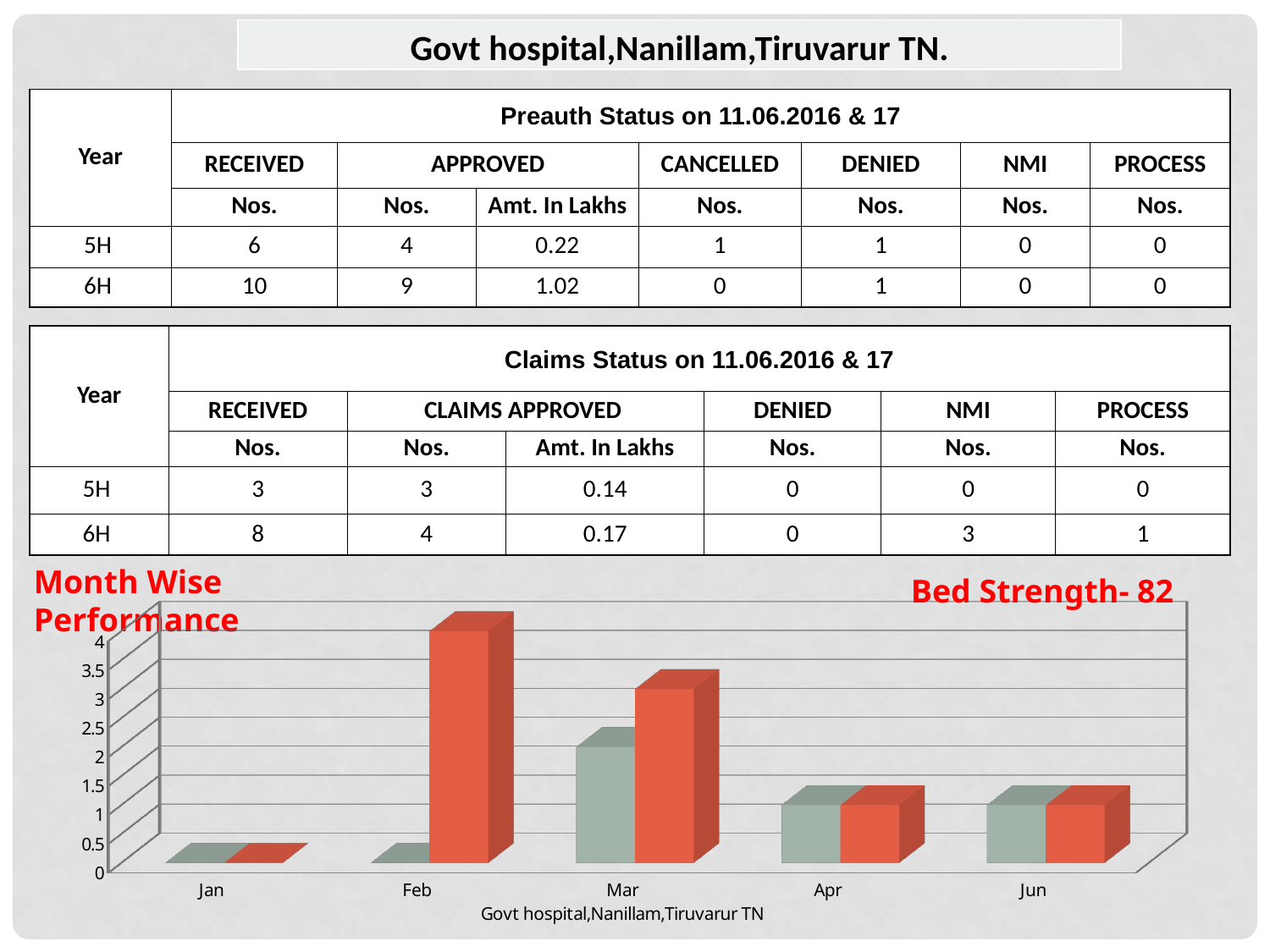
Which month has the lowest bars in the bar chart? Jan Which is taller, the red bar for Feb or the red bar for Mar? Feb Is the grey bar for Mar greater or less than 1.5? greater In Mar, which bar is taller, the grey bar or the red bar? red Do the red bars rise or fall from Feb to Apr? fall Is the red bar for Feb greater or less than 3? greater How many months are shown on the x axis of the bar chart? 5 What label is printed below the x axis of the bar chart? Govt hospital,Nanillam,Tiruvarur TN Is the grey bar for Jun greater or less than 2? less What kind of chart is shown at the bottom of the slide? bar chart Which month has the tallest red bar in the bar chart? Feb